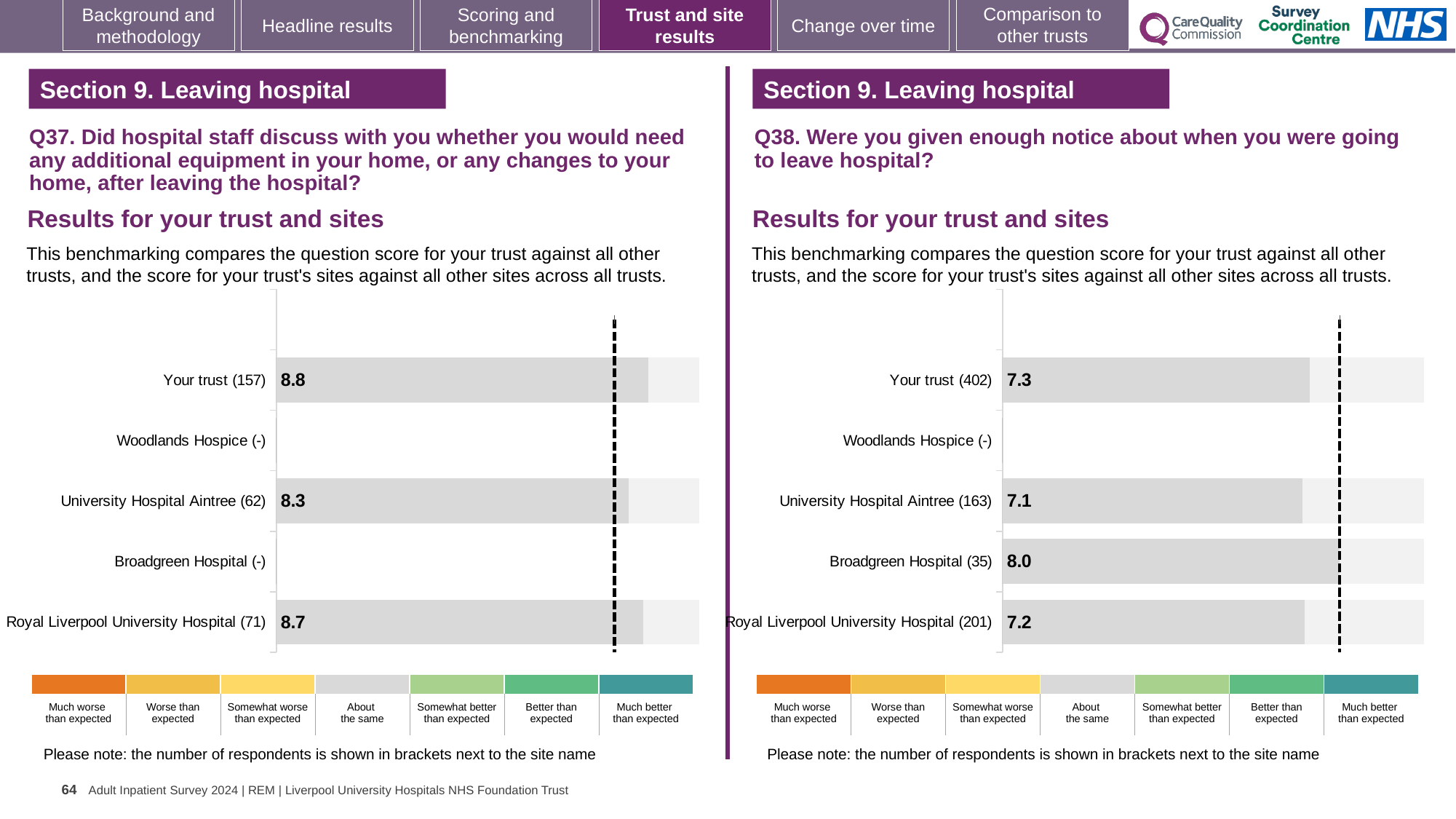
In the Q38 chart on the right, which site has the lowest score among those with a plotted value? University Hospital Aintree In the Q38 chart on the right, what is the score for Your trust? 7.3 What kind of chart is used in the Q37 chart on the left? bar chart In the Q37 chart on the left, which site has the lowest score among those with a plotted value? University Hospital Aintree In the Q37 chart on the left, what is the score for Royal Liverpool University Hospital? 8.7 In the Q37 chart on the left, what is the score for University Hospital Aintree? 8.3 How many categories are listed on the y axis of the Q38 chart on the right? 5 In the Q38 chart on the right, what is the score for Broadgreen Hospital? 8.0 In the Q38 chart on the right, which site has the highest score? Broadgreen Hospital In the Q37 chart on the left, what is the score for Your trust? 8.8 In the Q38 chart on the right, is the score for Royal Liverpool University Hospital larger or smaller than the score for University Hospital Aintree? larger In the Q37 chart on the left, what is the difference between the scores for Your trust and University Hospital Aintree? 0.5